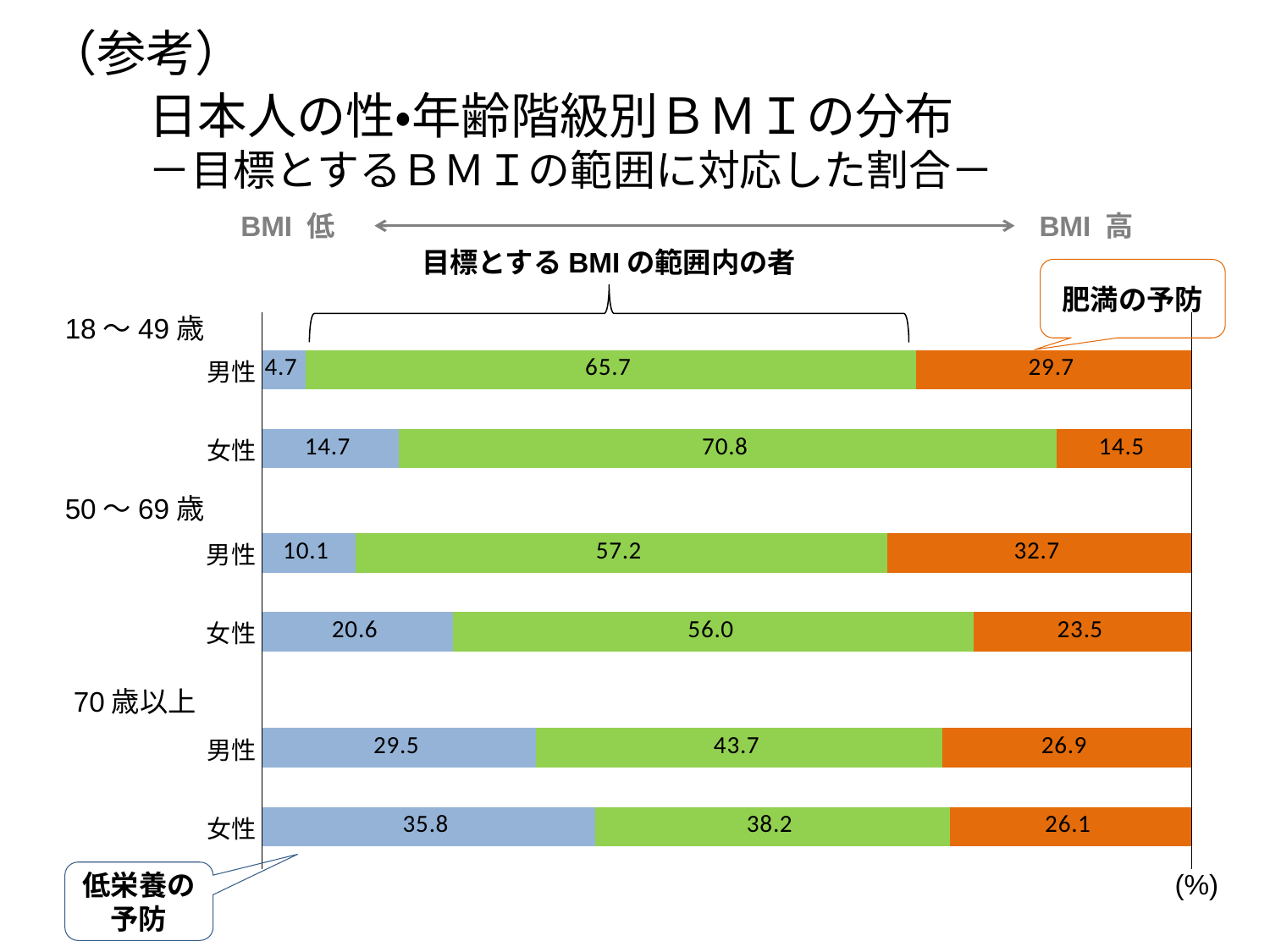
What is the value of the green (目標とするBMIの範囲内) segment for 18～49歳 男性? 65.7 How many bars are plotted in the chart? 6 Which is larger: the blue (BMI低) segment for 50～69歳 女性 or for 18～49歳 女性? 50～69歳 女性 Which group has the highest value for the green (目標とするBMIの範囲内) segment? 18～49歳 女性 Which segment does the callout 肥満の予防 point to? The orange (BMI高) segment What is the value of the blue (BMI低) segment for 70歳以上 女性? 35.8 What is the difference between the green segment values for 18～49歳 男性 and 70歳以上 男性? 22.0 For 男性, does the green (目標とするBMIの範囲内) segment rise or fall as the age group gets older? Fall Which group has the highest value for the orange (BMI高) segment? 50～69歳 男性 What is the value of the orange (BMI高) segment for 50～69歳 男性? 32.7 Which group has the lowest value for the green (目標とするBMIの範囲内) segment? 70歳以上 女性 What kind of chart is shown on the slide? Stacked bar chart